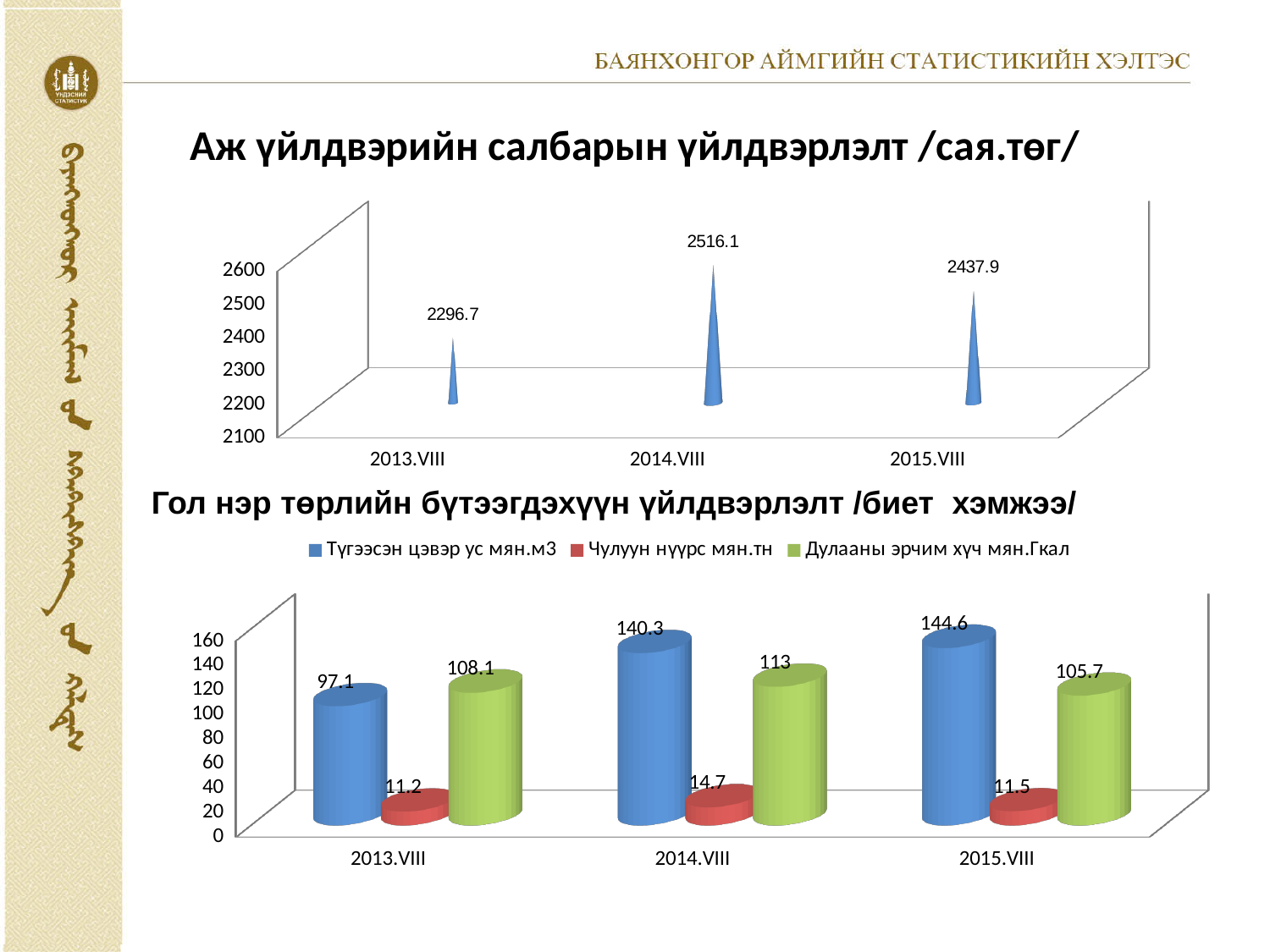
What kind of chart is the bottom chart (Гол нэр төрлийн бүтээгдэхүүн үйлдвэрлэлт)? Bar chart In the top chart (Аж үйлдвэрийн салбарын үйлдвэрлэлт), what is the difference between the 2014.VIII and 2013.VIII values? 219.4 In the bottom chart (Гол нэр төрлийн бүтээгдэхүүн үйлдвэрлэлт), which is larger for 2013.VIII: Түгээсэн цэвэр ус мян.м3 or Дулааны эрчим хүч мян.Гкал? Дулааны эрчим хүч мян.Гкал In the top chart (Аж үйлдвэрийн салбарын үйлдвэрлэлт), what is the value for 2014.VIII? 2516.1 In the bottom chart (Гол нэр төрлийн бүтээгдэхүүн үйлдвэрлэлт), how many series does the legend list? 3 In the bottom chart (Гол нэр төрлийн бүтээгдэхүүн үйлдвэрлэлт), which period has the highest value for Дулааны эрчим хүч мян.Гкал? 2014.VIII In the top chart (Аж үйлдвэрийн салбарын үйлдвэрлэлт), which period has the lowest value? 2013.VIII In the top chart (Аж үйлдвэрийн салбарын үйлдвэрлэлт), how many periods are shown on the x axis? 3 In the top chart (Аж үйлдвэрийн салбарын үйлдвэрлэлт), is the value for 2015.VIII greater or less than 2400? greater In the bottom chart (Гол нэр төрлийн бүтээгдэхүүн үйлдвэрлэлт), what is the value of Түгээсэн цэвэр ус мян.м3 for 2015.VIII? 144.6 In the bottom chart (Гол нэр төрлийн бүтээгдэхүүн үйлдвэрлэлт), what is the value of Чулуун нүүрс мян.тн for 2014.VIII? 14.7 In the bottom chart (Гол нэр төрлийн бүтээгдэхүүн үйлдвэрлэлт), what is the difference between the Түгээсэн цэвэр ус мян.м3 values for 2014.VIII and 2013.VIII? 43.2